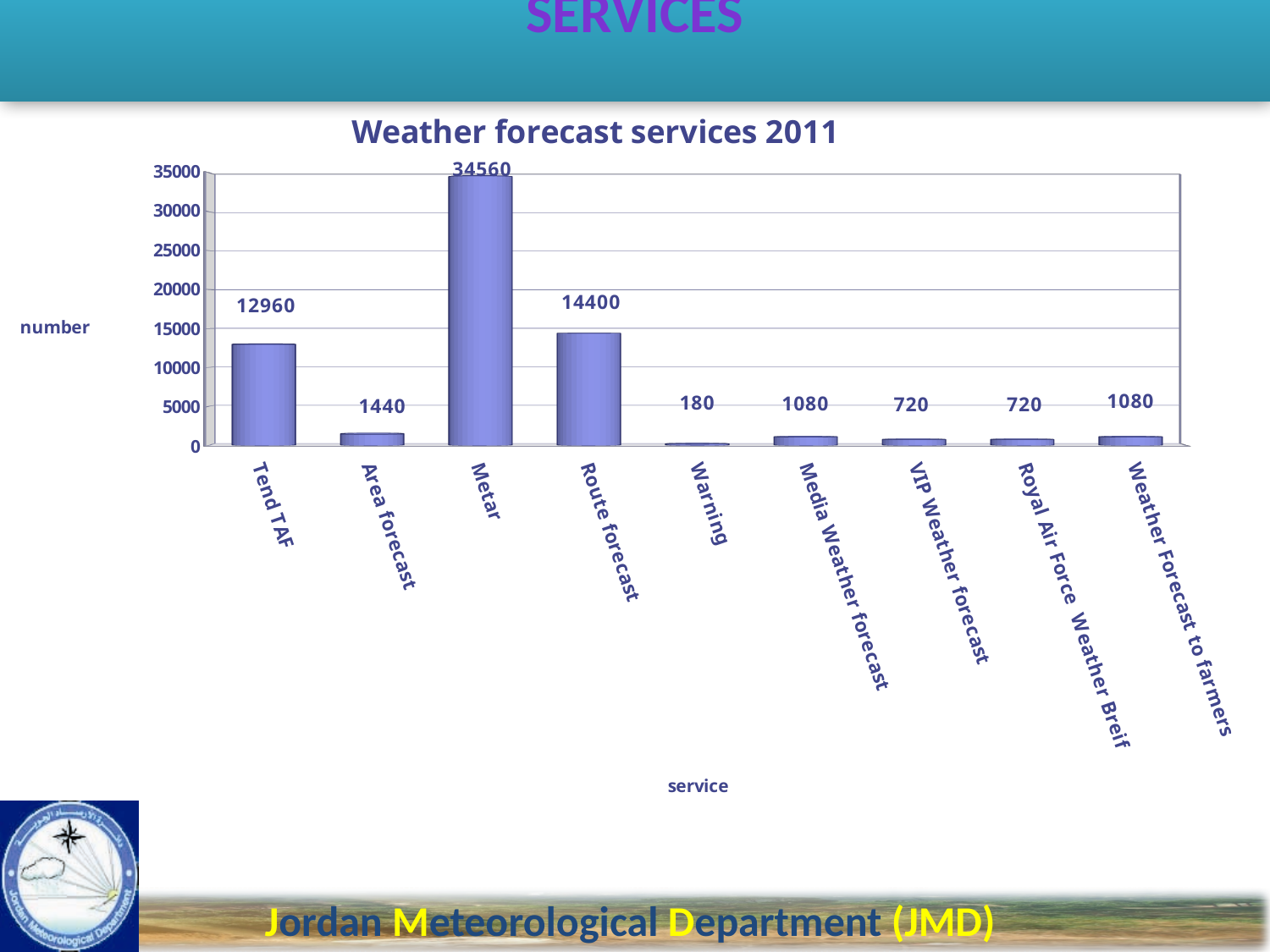
What is the value for Warning? 180 Is the value for Tend TAF greater or less than 10000? greater What is the value for Route forecast? 14400 Which service has the lowest value? Warning What is the difference between the values for Metar and Tend TAF? 21600 Which is larger, the value for Area forecast or the value for Media Weather forecast? Area forecast How many services are shown on the x axis? 9 Which service has the highest value? Metar What is the title of the chart? Weather forecast services 2011 What is the value for Metar? 34560 What kind of chart is this? bar chart What is the label of the vertical axis? number